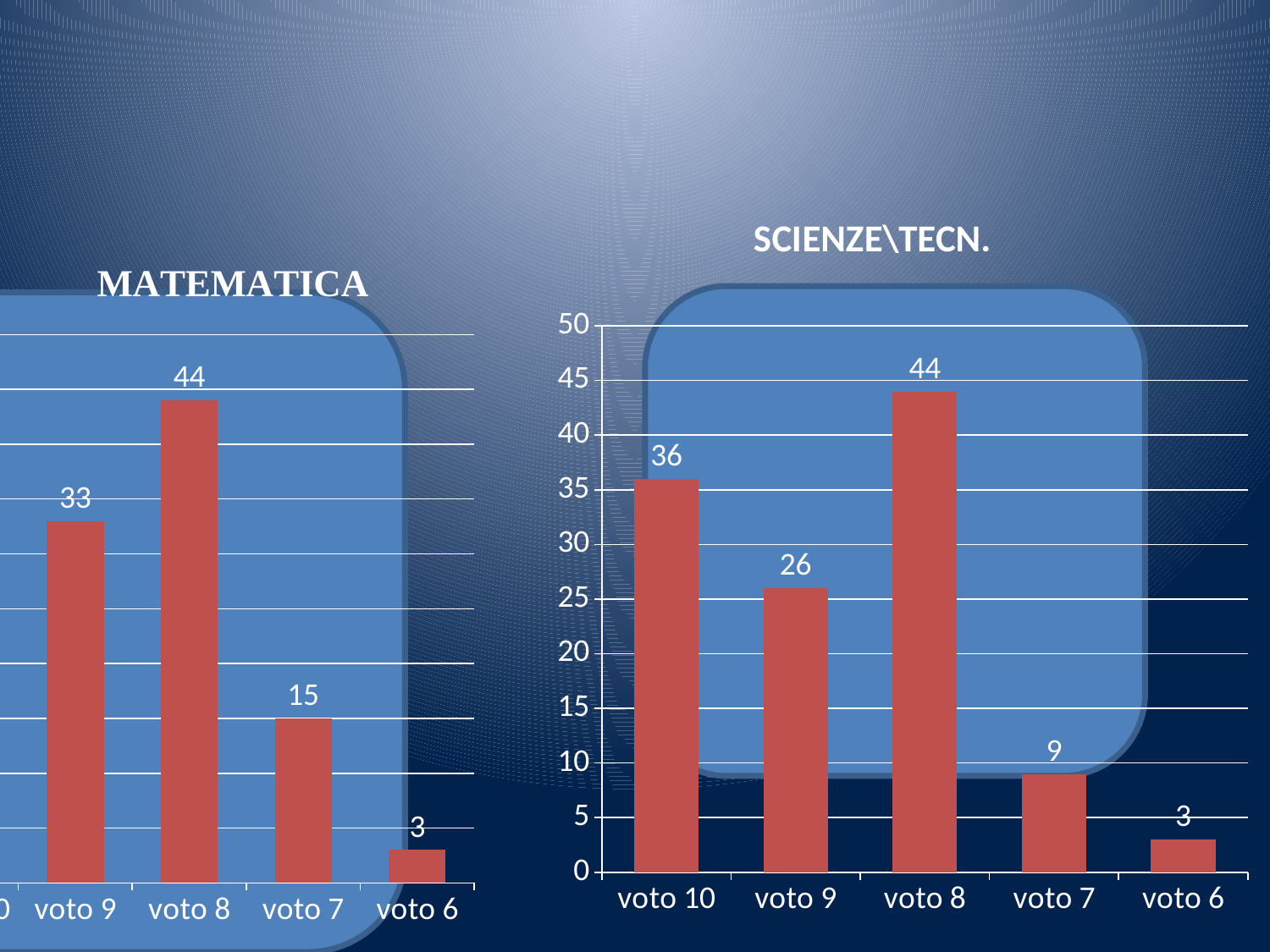
In the MATEMATICA chart, what is the value for voto 7? 15 In the SCIENZE\TECN. chart, what is the difference between the values for voto 8 and voto 7? 35 In the SCIENZE\TECN. chart, what is the value for voto 9? 26 In the SCIENZE\TECN. chart, is the value for voto 10 greater or less than 30? greater In the SCIENZE\TECN. chart, which category has the lowest value? voto 6 In the SCIENZE\TECN. chart, what is the value for voto 10? 36 In the SCIENZE\TECN. chart, which category has the highest value? voto 8 In the MATEMATICA chart, what is the value for voto 8? 44 In the MATEMATICA chart, what is the difference between the values for voto 9 and voto 6? 30 What kind of chart is the SCIENZE\TECN. chart? Bar chart In the MATEMATICA chart, which is larger, the value for voto 9 or the value for voto 8? voto 8 In the SCIENZE\TECN. chart, how many categories are shown on the x axis? 5